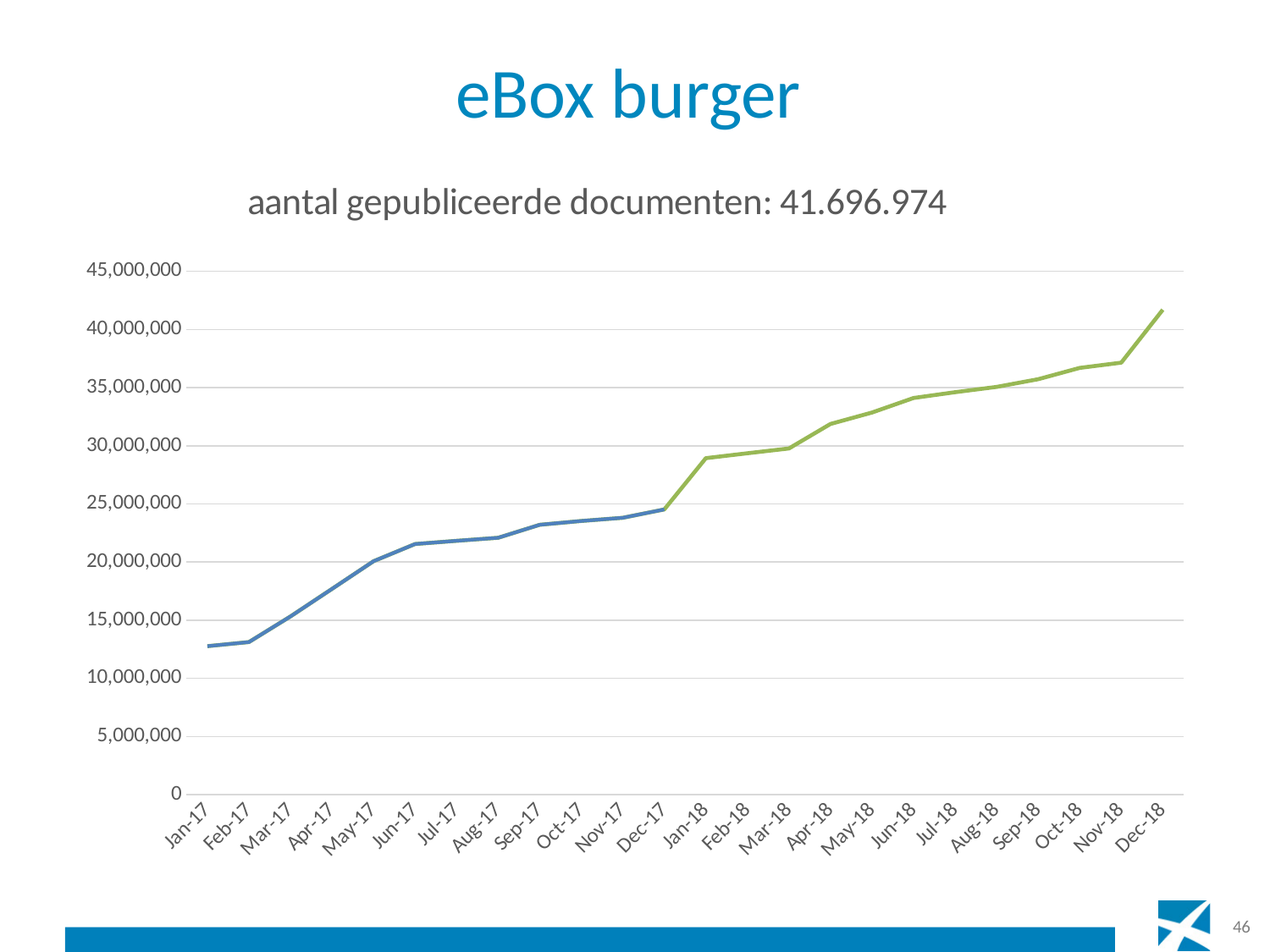
Does the plotted value rise or fall from Jan-17 to Dec-18? rise Is the value for Dec-17 greater or less than 25,000,000? less What total number of published documents is stated in the chart's subtitle? 41.696.974 How many monthly data points does the line chart plot? 24 Is the value for Jan-17 greater or less than 15,000,000? less Which is larger, the value for Jan-18 or the value for Jan-17? Jan-18 Is the value for Jun-18 greater or less than 35,000,000? less What kind of chart is shown on the slide? line chart Which month has the lowest value on the chart? Jan-17 Which month has the highest value on the chart? Dec-18